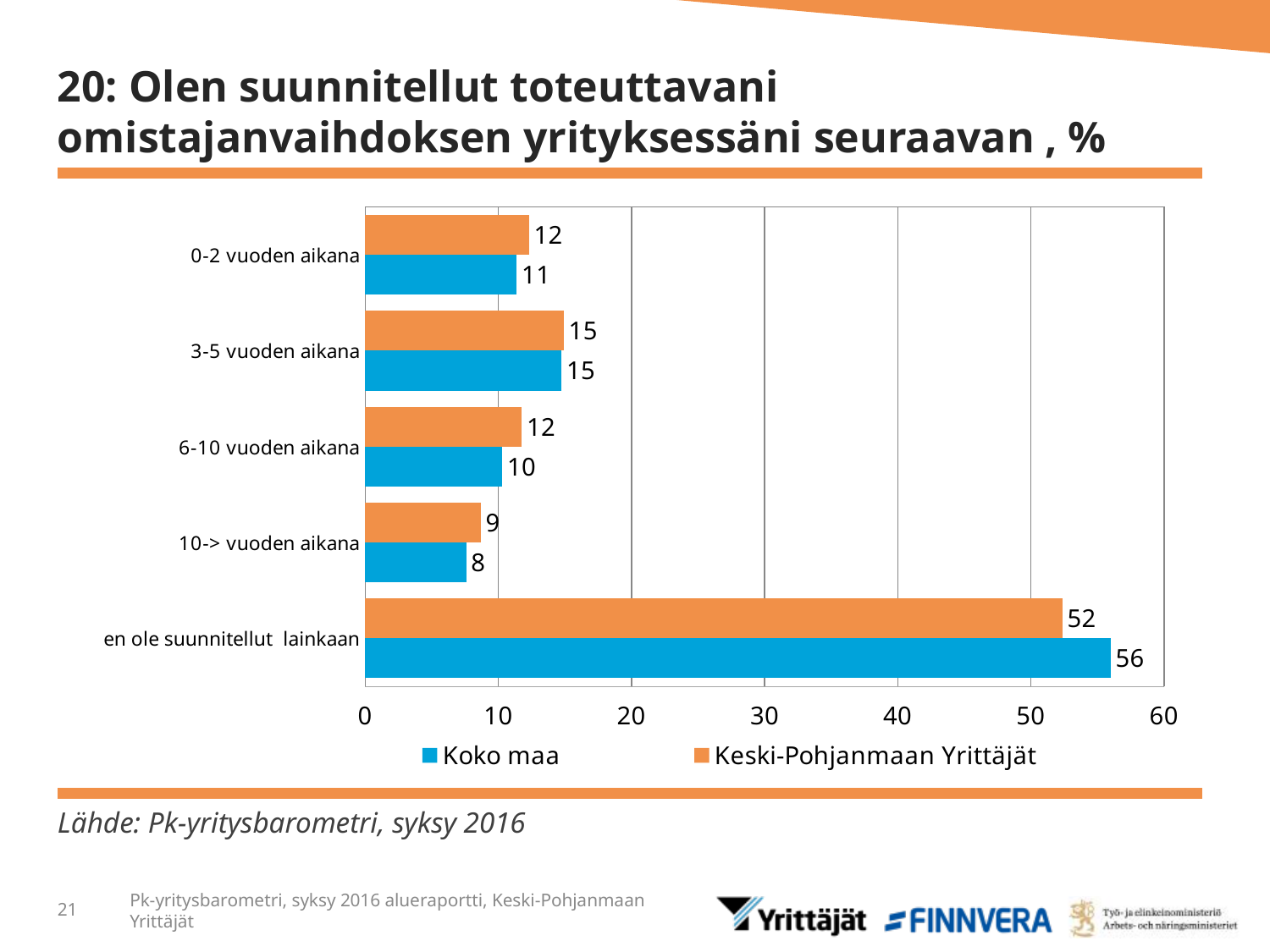
Which series has the larger value in the category '6-10 vuoden aikana'? Keski-Pohjanmaan Yrittäjät What is the value for Koko maa in the category 'en ole suunnitellut lainkaan'? 56 What is the value for Koko maa in the category '10-> vuoden aikana'? 8 What kind of chart is shown on the slide? bar chart How many series does the legend list? 2 What is the value for Keski-Pohjanmaan Yrittäjät in the category '3-5 vuoden aikana'? 15 Which category has the lowest value for Koko maa? 10-> vuoden aikana Is the value for Koko maa in 'en ole suunnitellut lainkaan' greater or less than 50? greater Which colour represents Koko maa in the chart? blue How many categories are shown on the chart? 5 Which category has the highest value for Keski-Pohjanmaan Yrittäjät? en ole suunnitellut lainkaan What is the difference between Koko maa and Keski-Pohjanmaan Yrittäjät in the category 'en ole suunnitellut lainkaan'? 4